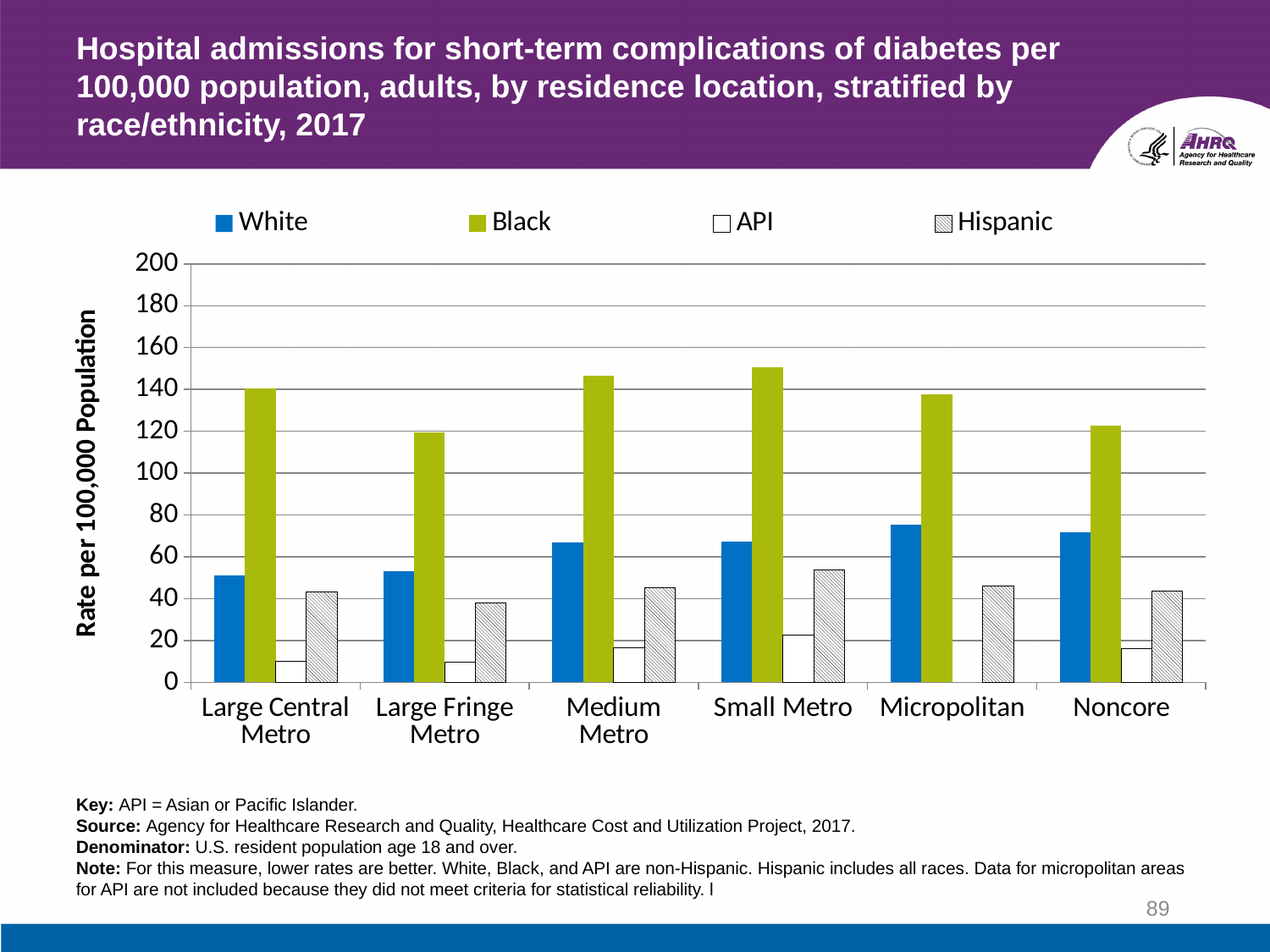
How many series does the legend list? 4 Is the value for Black in Large Fringe Metro greater or less than 140? less Which race/ethnicity group has the lowest rate in every residence location where it is shown? API Which residence location has the highest API rate? Small Metro Which residence location has no API bar shown? Micropolitan Is the value for White in Micropolitan greater or less than 60? greater Is the value for Black in Large Central Metro greater or less than 120? greater In Medium Metro, which is larger, the White rate or the Black rate? Black Which race/ethnicity group has the highest rate in every residence location? Black What kind of chart is shown on the slide? Bar chart How many residence location categories are shown on the x axis? 6 Which residence location has the highest Hispanic rate? Small Metro